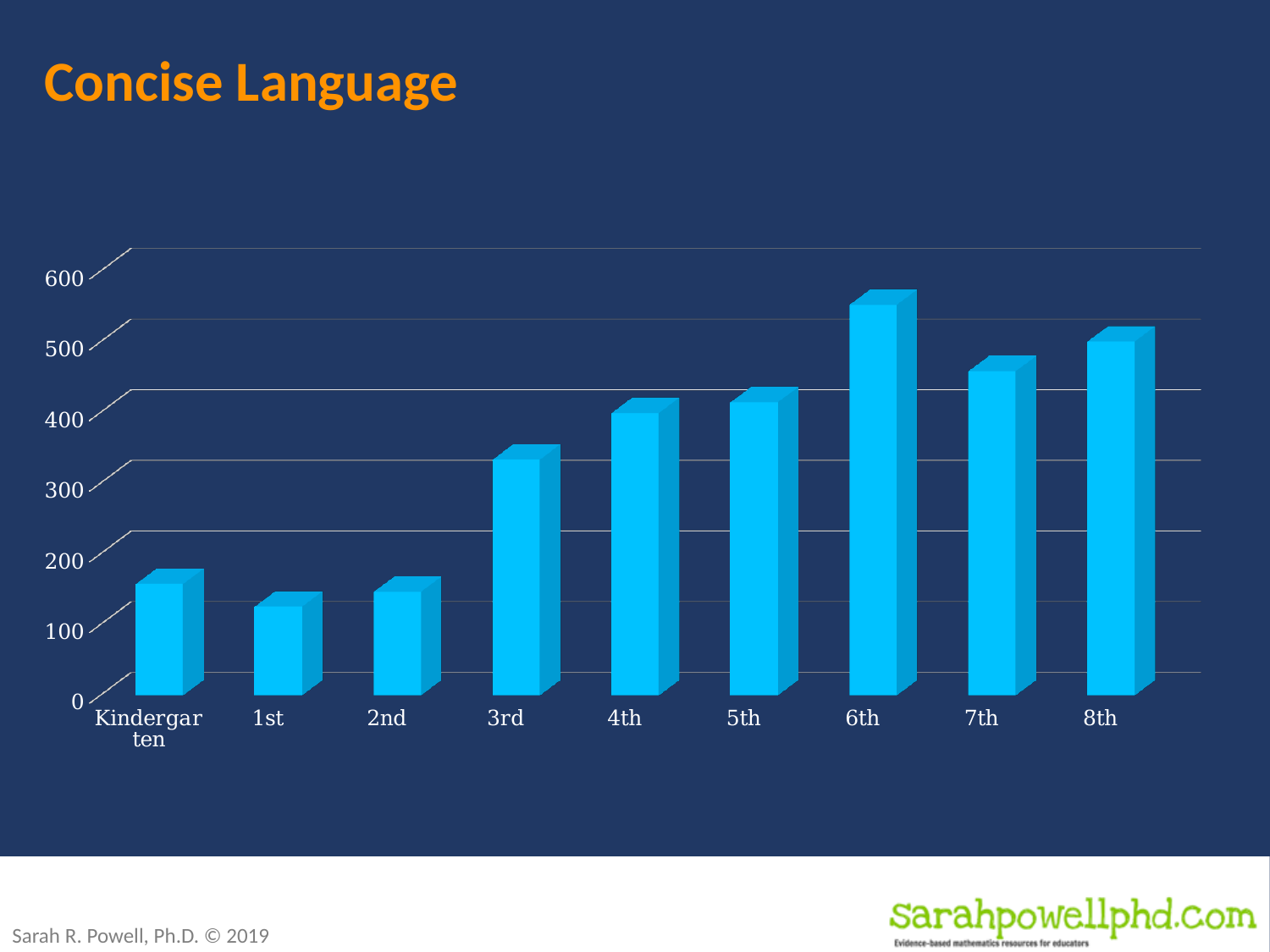
What kind of chart is shown on the slide? bar chart What is the highest value labelled on the vertical axis? 600 Is the value for 3rd greater or less than 300? greater Is the value for Kindergarten greater or less than 200? less How many grade categories are plotted on the x axis? 9 Which is larger, the value for 2nd or the value for 3rd? 3rd Is the value for 1st greater or less than 100? greater Which grade has the highest bar? 6th Which is larger, the value for 6th or the value for 8th? 6th Which grade has the lowest bar? 1st